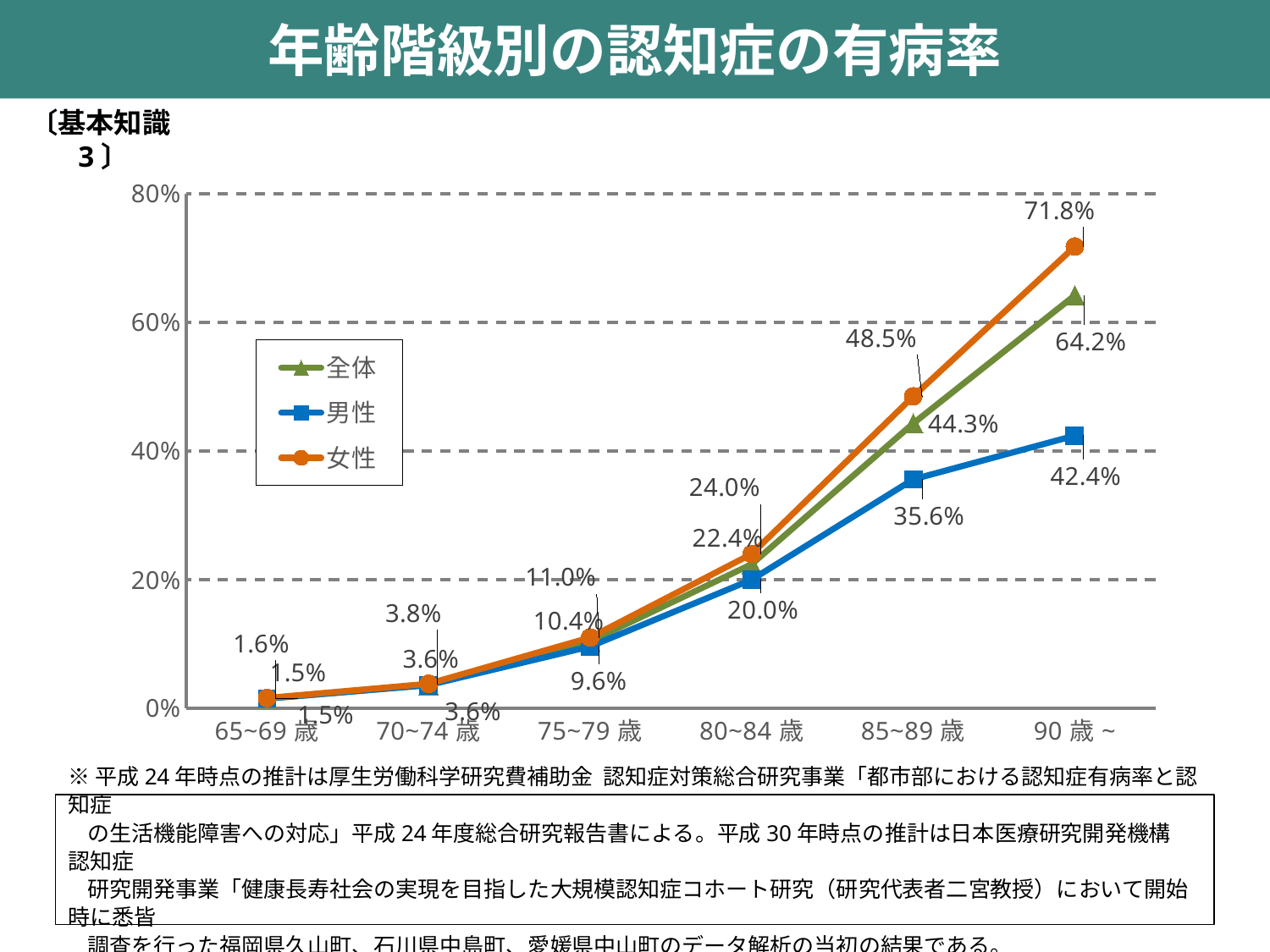
How many series does the legend list? 3 What is the difference between the 女性 and 男性 values in the 90歳~ age group? 29.4% What is the value for 男性 in the 80~84歳 age group? 20.0% In the 85~89歳 age group, which is larger, the value for 女性 or for 男性? 女性 What is the value for 女性 in the 90歳~ age group? 71.8% What is the value for 男性 in the 85~89歳 age group? 35.6% How many age groups are shown on the x axis? 6 Which age group has the highest value for 女性? 90歳~ What is the value for 男性 in the 90歳~ age group? 42.4% What is the value for 全体 in the 90歳~ age group? 64.2% What type of chart is shown on the slide? line chart Do the values for 全体 rise or fall as the age group increases along the x axis? rise